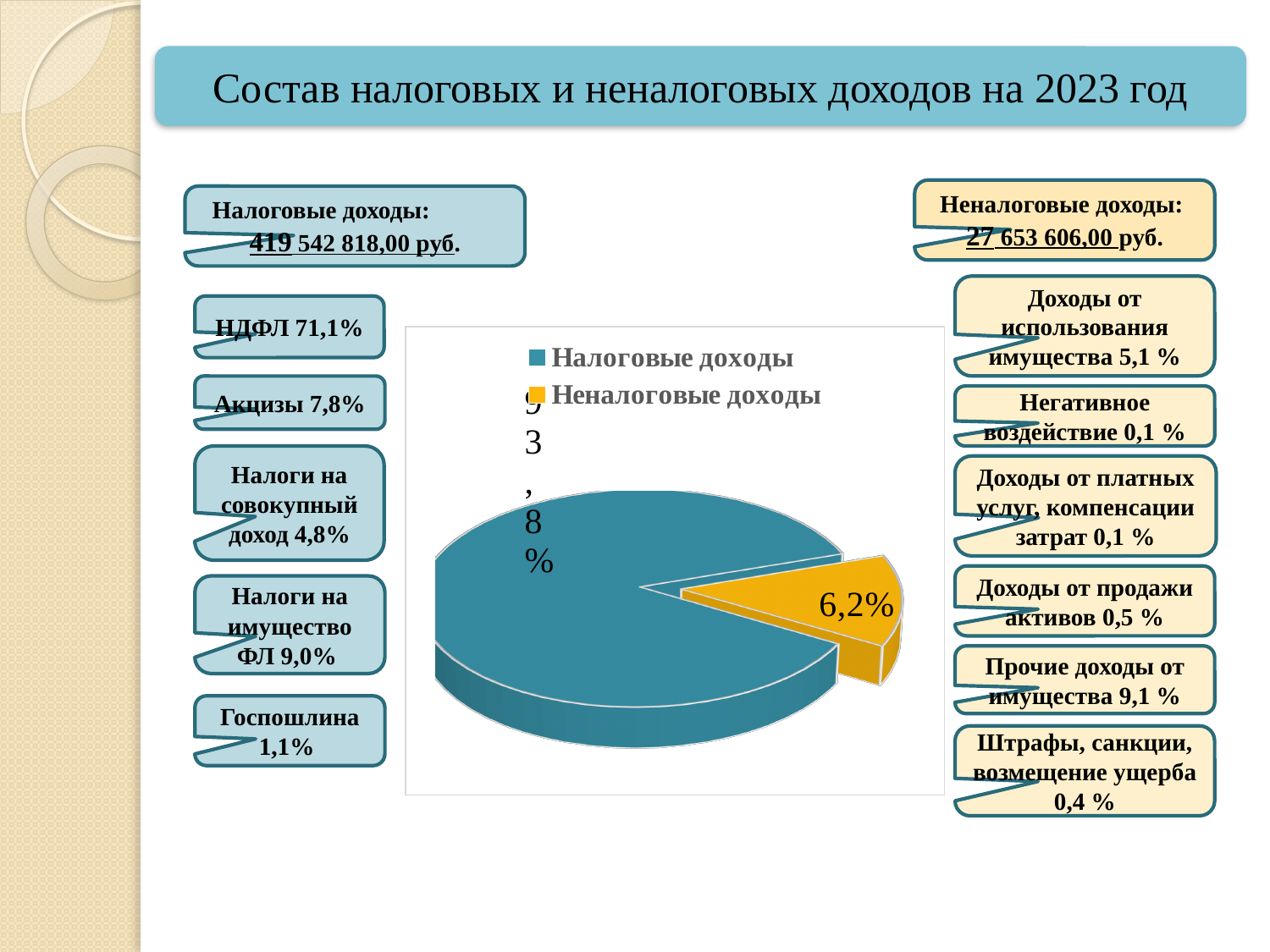
Is the share of Налоговые доходы in the pie chart greater or less than 50%? greater How many entries does the legend of the pie chart list? 2 What are the two legend entries of the pie chart? Налоговые доходы, Неналоговые доходы Which slice of the pie chart is the smallest? Неналоговые доходы What colour is the Неналоговые доходы slice in the pie chart? Yellow Which is larger in the pie chart, Налоговые доходы or Неналоговые доходы? Налоговые доходы What kind of chart is shown on the slide? Pie chart How many slices does the pie chart have? 2 Which slice of the pie chart is the largest? Налоговые доходы What share of the pie does Неналоговые доходы have? 6,2%